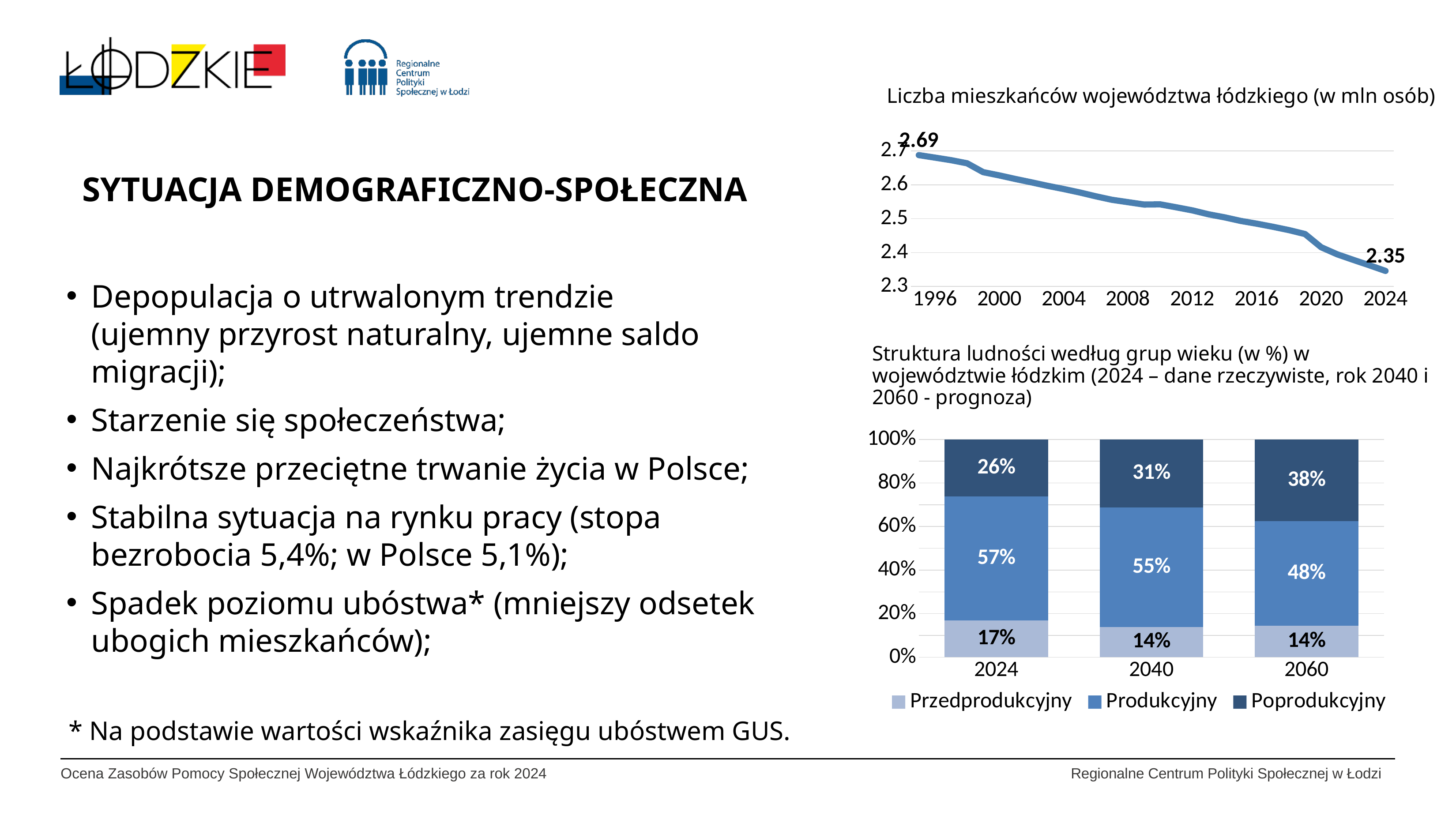
In the chart 'Liczba mieszkańców województwa łódzkiego (w mln osób)', what is the value labelled at the end of the line in 2024? 2.35 In the stacked bar chart 'Struktura ludności według grup wieku', how many series does the legend list? 3 In the stacked bar chart 'Struktura ludności według grup wieku', what is the Poprodukcyjny share for 2060? 38% In the stacked bar chart 'Struktura ludności według grup wieku', what is the Produkcyjny share for 2024? 57% In the chart 'Liczba mieszkańców województwa łódzkiego (w mln osób)', do the values rise or fall from 1996 to 2024? fall In the stacked bar chart 'Struktura ludności według grup wieku', what is the difference between the Produkcyjny share in 2024 and in 2060? 9% In the chart 'Liczba mieszkańców województwa łódzkiego (w mln osób)', by how much did the value decrease between the labelled 1996 and 2024 points? 0.34 In the stacked bar chart 'Struktura ludności według grup wieku', how many years are shown on the x axis? 3 What kind of chart is 'Liczba mieszkańców województwa łódzkiego (w mln osób)'? line chart In the chart 'Liczba mieszkańców województwa łódzkiego (w mln osób)', what is the value labelled at the start of the line in 1996? 2.69 In the chart 'Liczba mieszkańców województwa łódzkiego (w mln osób)', is the value for 2012 greater or less than 2.6? less In the stacked bar chart 'Struktura ludności według grup wieku', which year has the highest Poprodukcyjny share? 2060